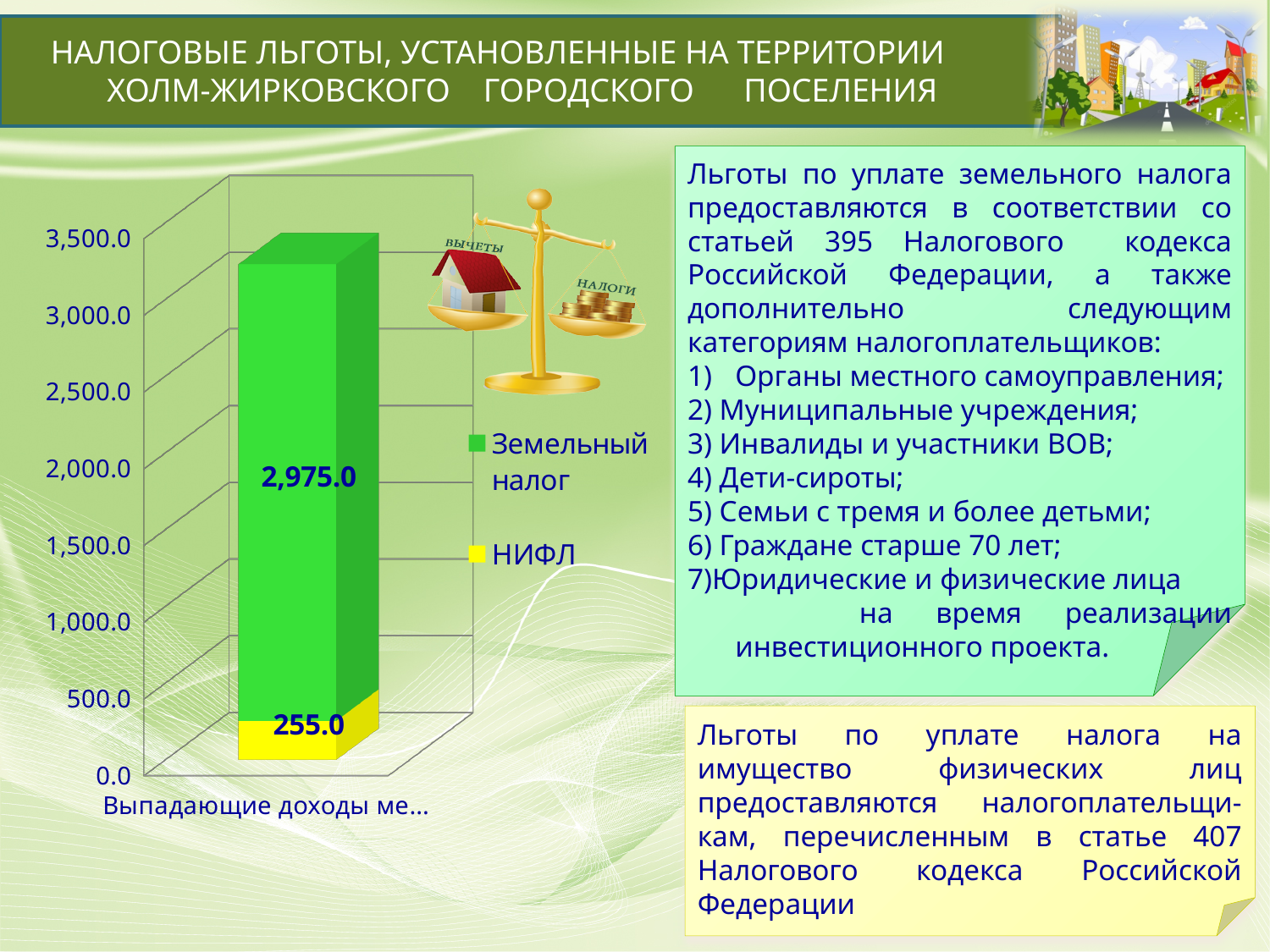
Which series has the larger value in the bar, Земельный налог or НИФЛ? Земельный налог What kind of chart is shown on the slide? Stacked bar chart Which series has the largest value in the chart? Земельный налог Which series has the smallest value in the chart? НИФЛ How many bars are plotted in the chart? 1 What is the difference between the Земельный налог value and the НИФЛ value? 2,720.0 Is the value for Земельный налог greater or less than 2,500.0? greater What is the value of the Земельный налог segment in the stacked bar? 2,975.0 What is the total of the stacked bar (Земельный налог plus НИФЛ)? 3,230.0 How many series does the legend list? 2 What is the value of the НИФЛ segment in the stacked bar? 255.0 What colour represents the НИФЛ series in the chart? Yellow